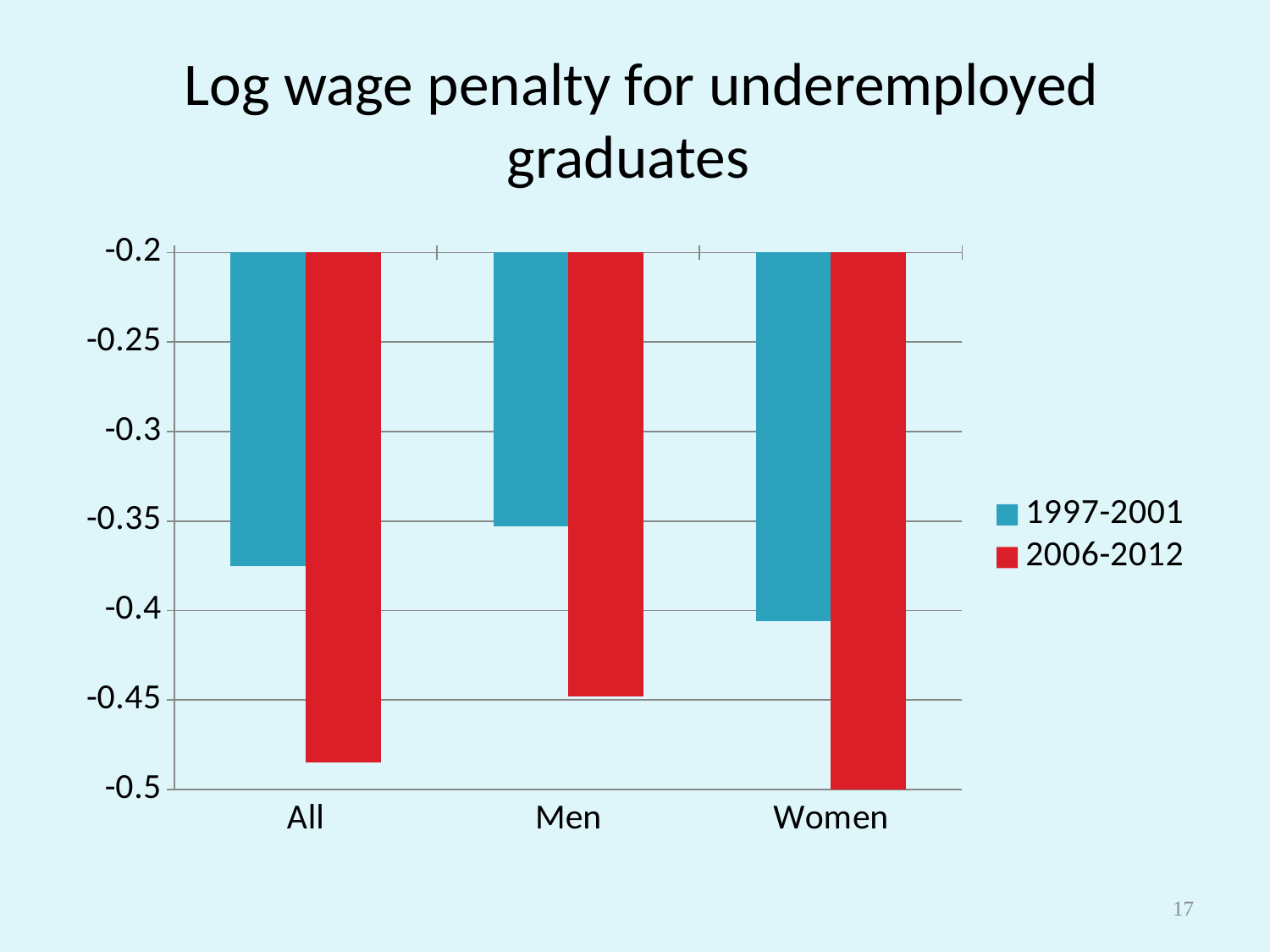
What kind of chart is shown on the slide? bar chart Is the value for Women in the 1997-2001 series greater or less than -0.45? greater Is the value for All in the 1997-2001 series greater or less than -0.35? less How many categories are shown on the x axis? 3 Which category has the highest (least negative) value in the 1997-2001 series? Men Which series is shown in red? 2006-2012 Is the value for Men in the 1997-2001 series greater or less than -0.3? less How many series does the legend list? 2 In the 2006-2012 series, which has the higher (less negative) value, Men or Women? Men What is the title of the chart? Log wage penalty for underemployed graduates Which category has the lowest (most negative) value in the 2006-2012 series? Women